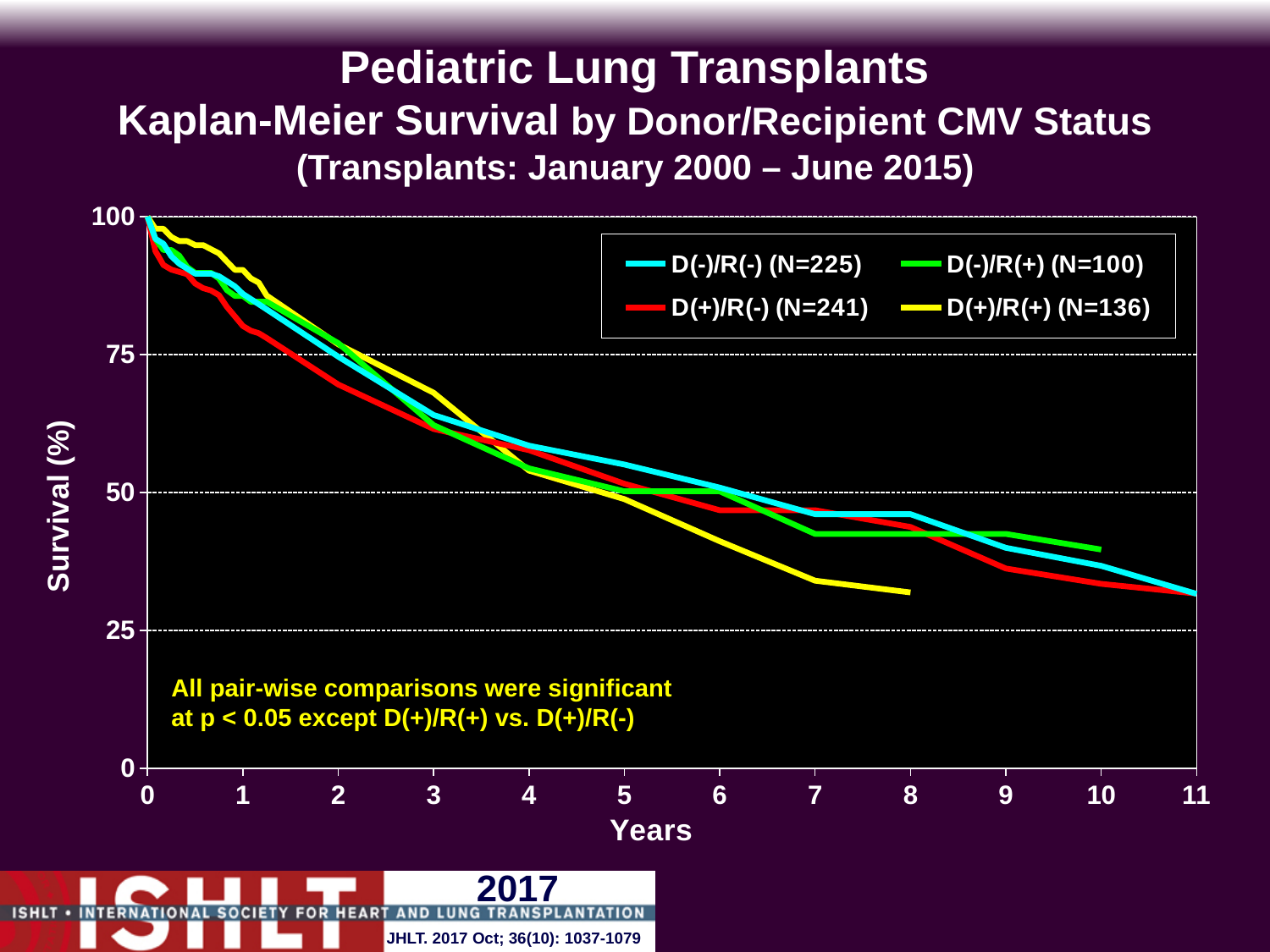
Do the survival curves rise or fall as years increase? fall What is the label of the x axis? Years Is the survival value for D(-)/R(+) at 5 years greater or less than 25? greater Is the survival value for D(-)/R(-) at 11 years greater or less than 50? less Is the survival value for D(+)/R(+) at 8 years greater or less than 50? less Which series has the largest N according to the legend? D(+)/R(-) (N=241) How many series does the legend list? 4 At 8 years, which has higher survival: D(-)/R(-) or D(+)/R(+)? D(-)/R(-) What kind of chart is shown on the slide? line chart Which series has the lowest survival at 7 years? D(+)/R(+) (N=136)